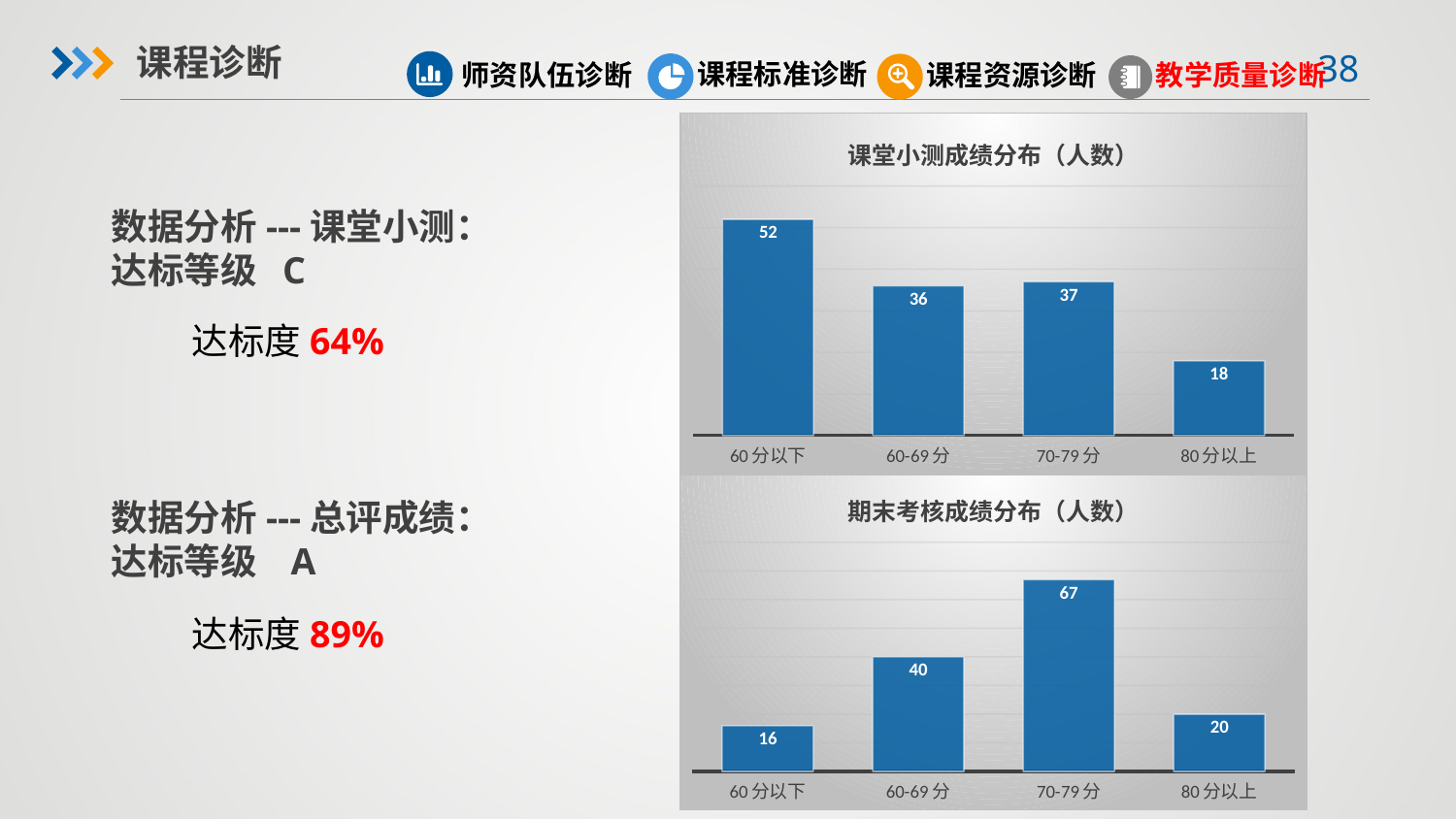
In the chart titled 期末考核成绩分布（人数）, what is the difference between the values for 70-79分 and 60-69分? 27 What type of chart is the chart titled 期末考核成绩分布（人数）? Bar chart In the chart titled 期末考核成绩分布（人数）, what is the value for 70-79分? 67 In the chart titled 课堂小测成绩分布（人数）, what is the value for 60分以下? 52 In the chart titled 期末考核成绩分布（人数）, which is larger, the value for 60-69分 or the value for 80分以上? 60-69分 In the chart titled 期末考核成绩分布（人数）, which category has the highest value? 70-79分 What is the title of the top chart on the slide? 课堂小测成绩分布（人数） In the chart titled 课堂小测成绩分布（人数）, what is the difference between the values for 60分以下 and 80分以上? 34 In the chart titled 课堂小测成绩分布（人数）, which category has the highest value? 60分以下 In the chart titled 课堂小测成绩分布（人数）, which category has the lowest value? 80分以上 In the chart titled 课堂小测成绩分布（人数）, how many categories are shown on the x axis? 4 In the chart titled 期末考核成绩分布（人数）, what is the value for 60分以下? 16